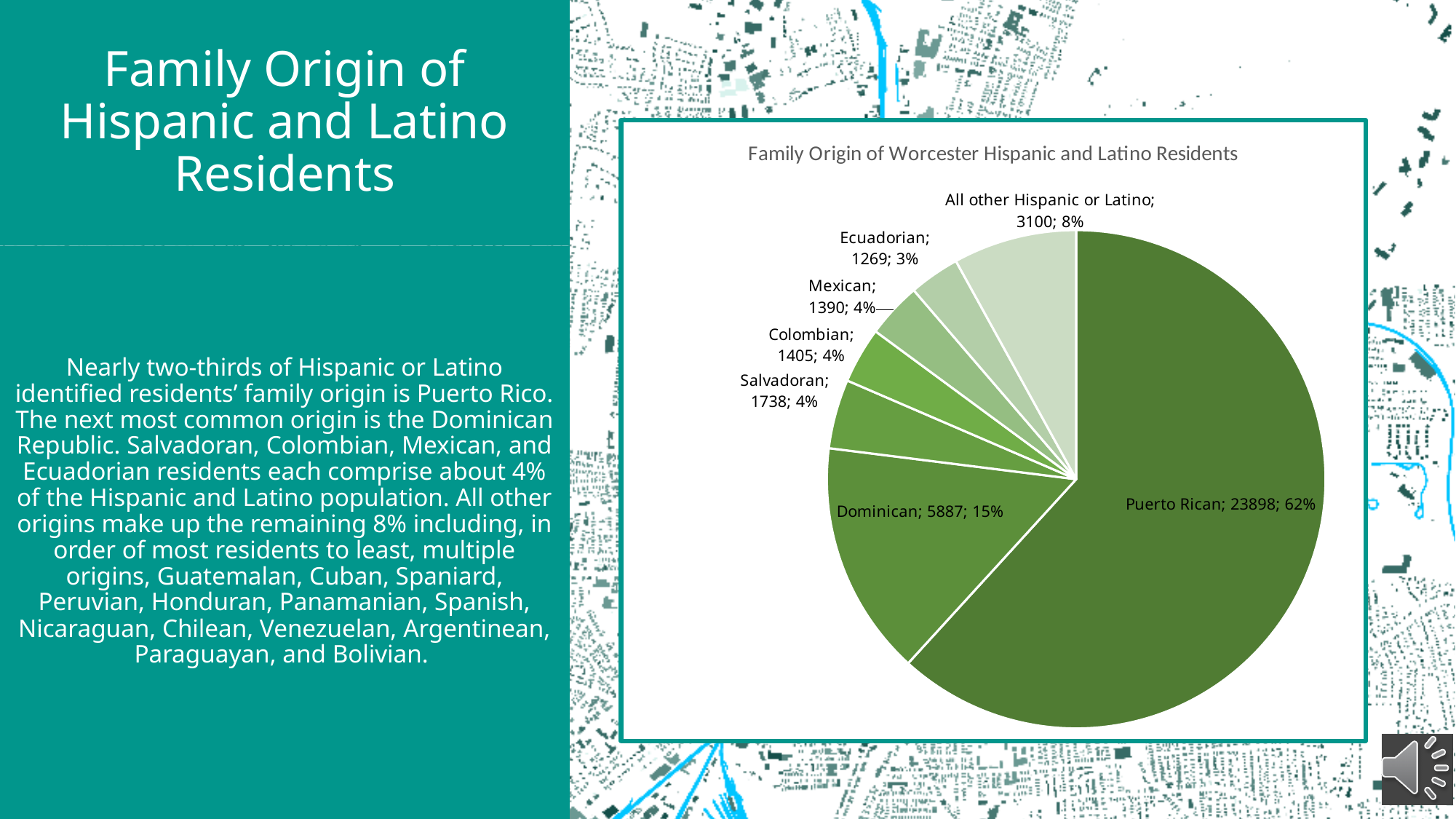
What is the title of the chart? Family Origin of Worcester Hispanic and Latino Residents What percentage share does the Dominican slice represent? 15% Which family origin has the smallest slice of the pie? Ecuadorian How many slices does the pie chart have? 7 What type of chart is shown on the slide? pie chart How many residents are of Puerto Rican family origin according to the chart? 23898 What is the difference between the Puerto Rican and Dominican values? 18011 What percentage share does the 'All other Hispanic or Latino' slice represent? 8% Which is larger, the Colombian value or the Mexican value? Colombian What is the value shown for Ecuadorian? 1269 How many residents are of Salvadoran family origin? 1738 Which family origin has the largest slice of the pie? Puerto Rican